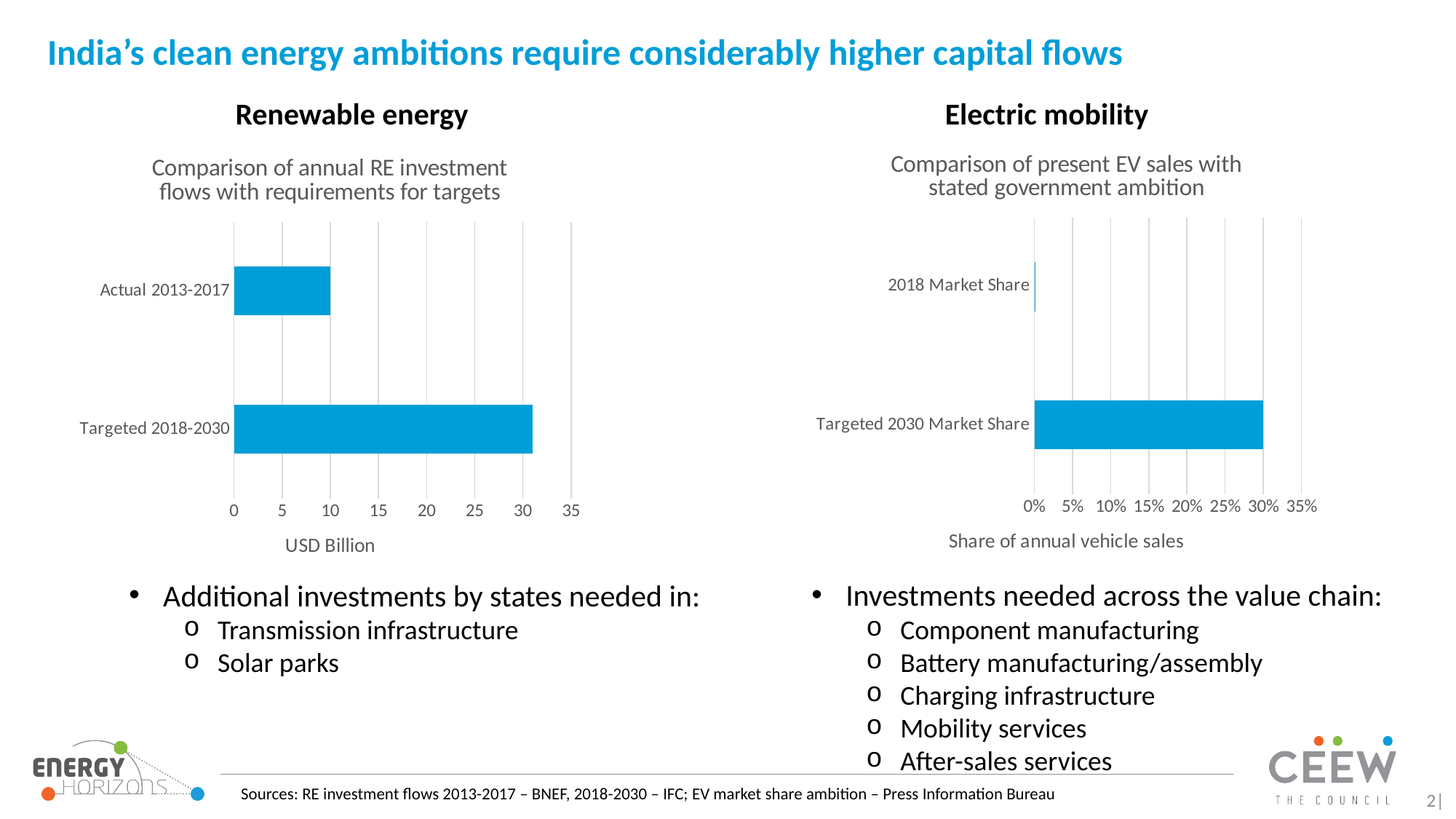
In the 'Comparison of present EV sales with stated government ambition' chart, which category has the lowest value? 2018 Market Share In the 'Comparison of annual RE investment flows with requirements for targets' chart, how many categories are plotted? 2 In the 'Comparison of annual RE investment flows with requirements for targets' chart, which category has the highest value? Targeted 2018-2030 In the 'Comparison of annual RE investment flows with requirements for targets' chart, is the value for Targeted 2018-2030 greater or less than 25? greater In the 'Comparison of present EV sales with stated government ambition' chart, how many categories are plotted? 2 In the 'Comparison of present EV sales with stated government ambition' chart, is the value for 2018 Market Share greater or less than 5%? less In the 'Comparison of annual RE investment flows with requirements for targets' chart, what unit is shown on the horizontal axis? USD Billion In the 'Comparison of present EV sales with stated government ambition' chart, what is the horizontal axis label? Share of annual vehicle sales In the 'Comparison of present EV sales with stated government ambition' chart, what is the value for Targeted 2030 Market Share? 30% In the 'Comparison of present EV sales with stated government ambition' chart, which is larger: 2018 Market Share or Targeted 2030 Market Share? Targeted 2030 Market Share In the 'Comparison of annual RE investment flows with requirements for targets' chart, what kind of chart is shown? Bar chart In the 'Comparison of annual RE investment flows with requirements for targets' chart, what is the value for Actual 2013-2017? 10